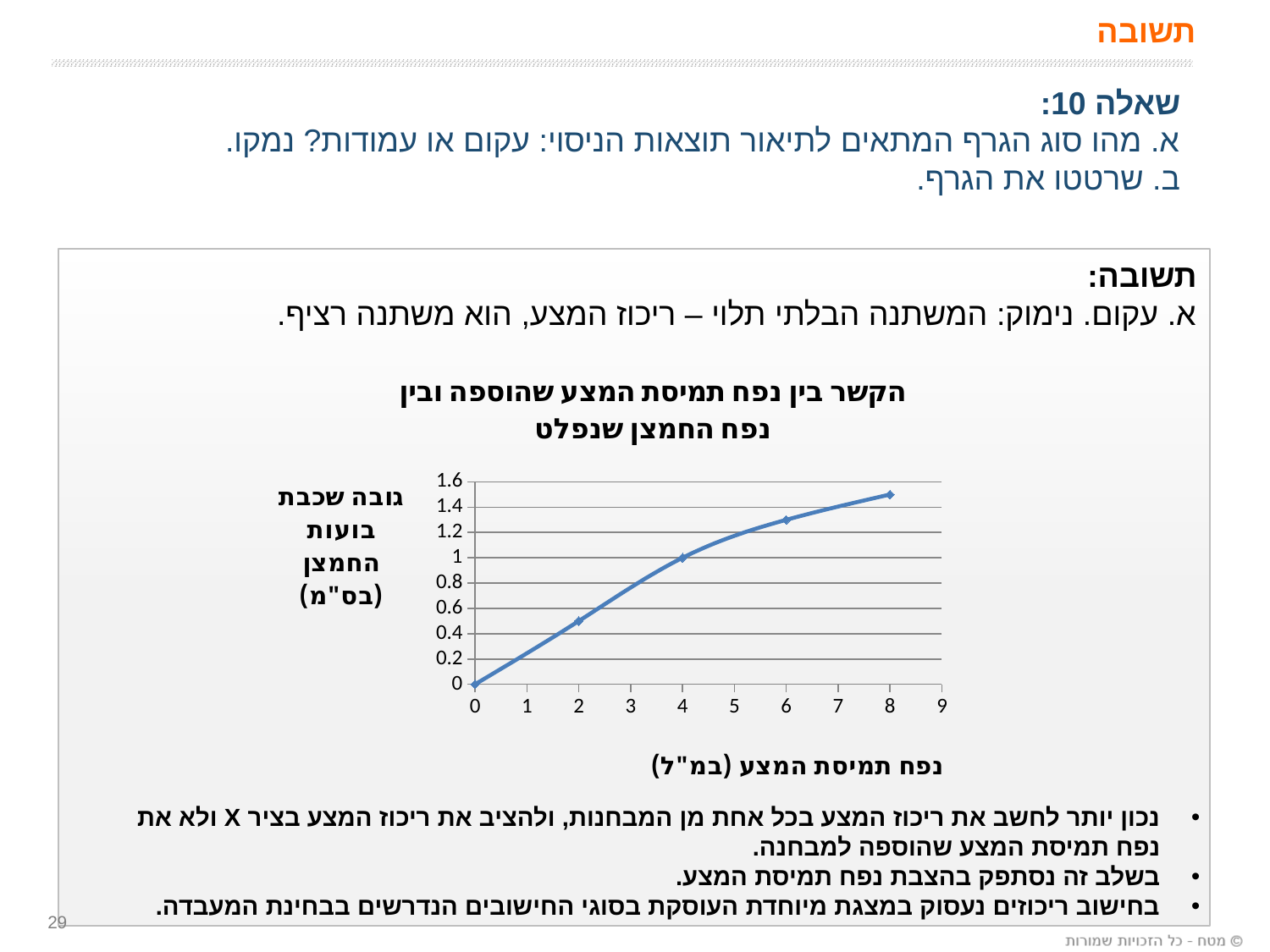
Do the values rise or fall as the x-axis value increases? rise Is the plotted value at x = 2 greater or less than 0.4? greater What is the label of the x-axis of the chart? נפח תמיסת המצע (במ"ל) Which has the larger plotted value, x = 2 or x = 6? x = 6 At which x-axis value is the plotted value highest? 8 Is the plotted value at x = 8 greater or less than 1.4? greater At which x-axis value is the plotted value lowest? 0 How many data points are plotted on the line? 5 What kind of chart is shown on the slide? line chart What is the plotted value at x = 0? 0 What is the plotted value at x = 4? 1 Is the plotted value at x = 6 greater or less than 1.2? greater